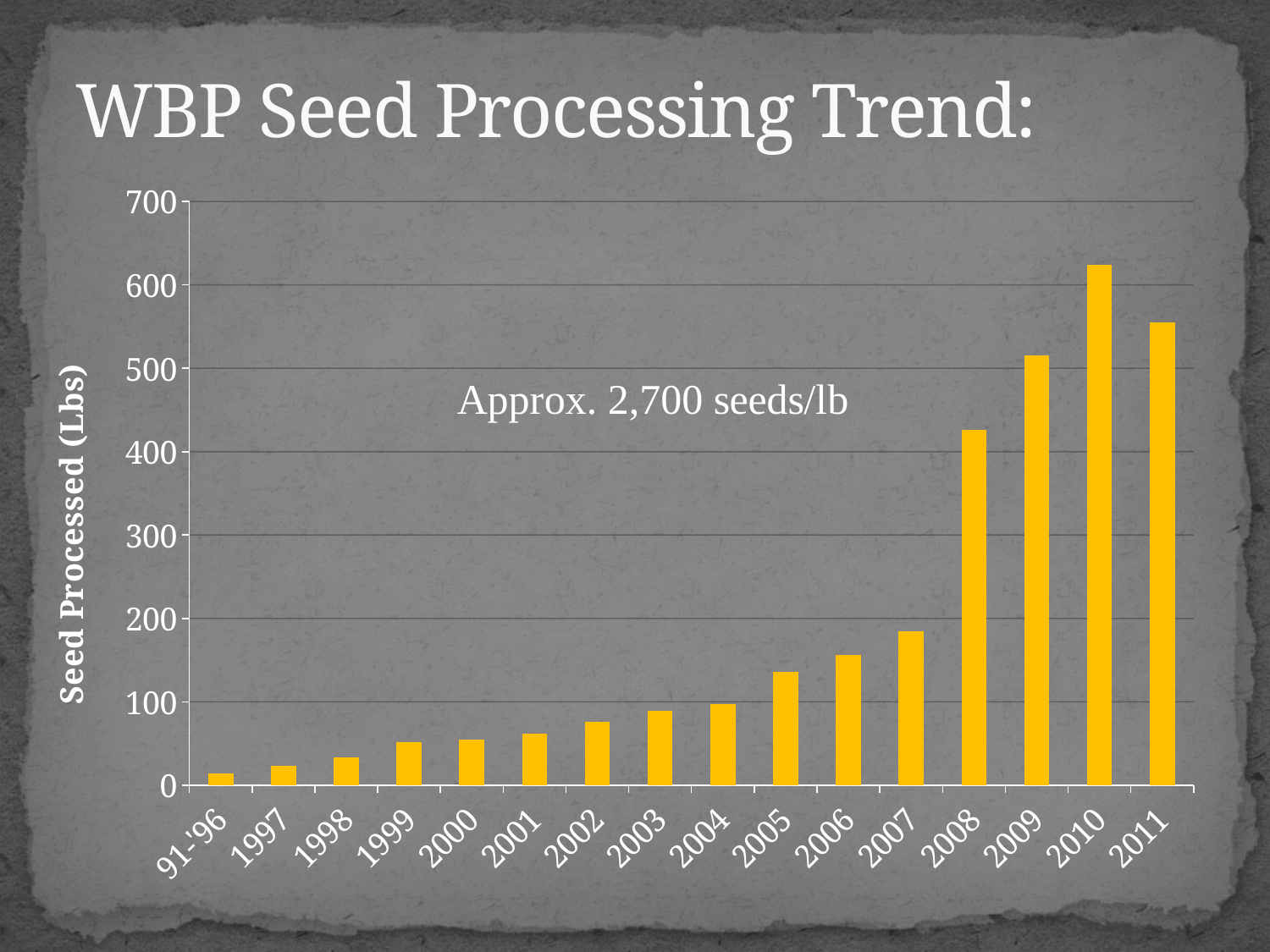
Which period has the lowest amount of seed processed? 91-'96 Do the values generally rise or fall from 91-'96 to 2010? rise Which is larger, the value for 2011 or the value for 2009? 2011 What is the label on the y axis? Seed Processed (Lbs) Which is larger, the value for 2005 or the value for 2003? 2005 What kind of chart is shown on the slide? bar chart Is the value for 2010 greater or less than 600? greater Is the value for 2009 greater or less than 500? greater How many categories (time periods) are shown on the x axis? 16 Which year has the highest amount of seed processed? 2010 Is the value for 2007 greater or less than 200? less